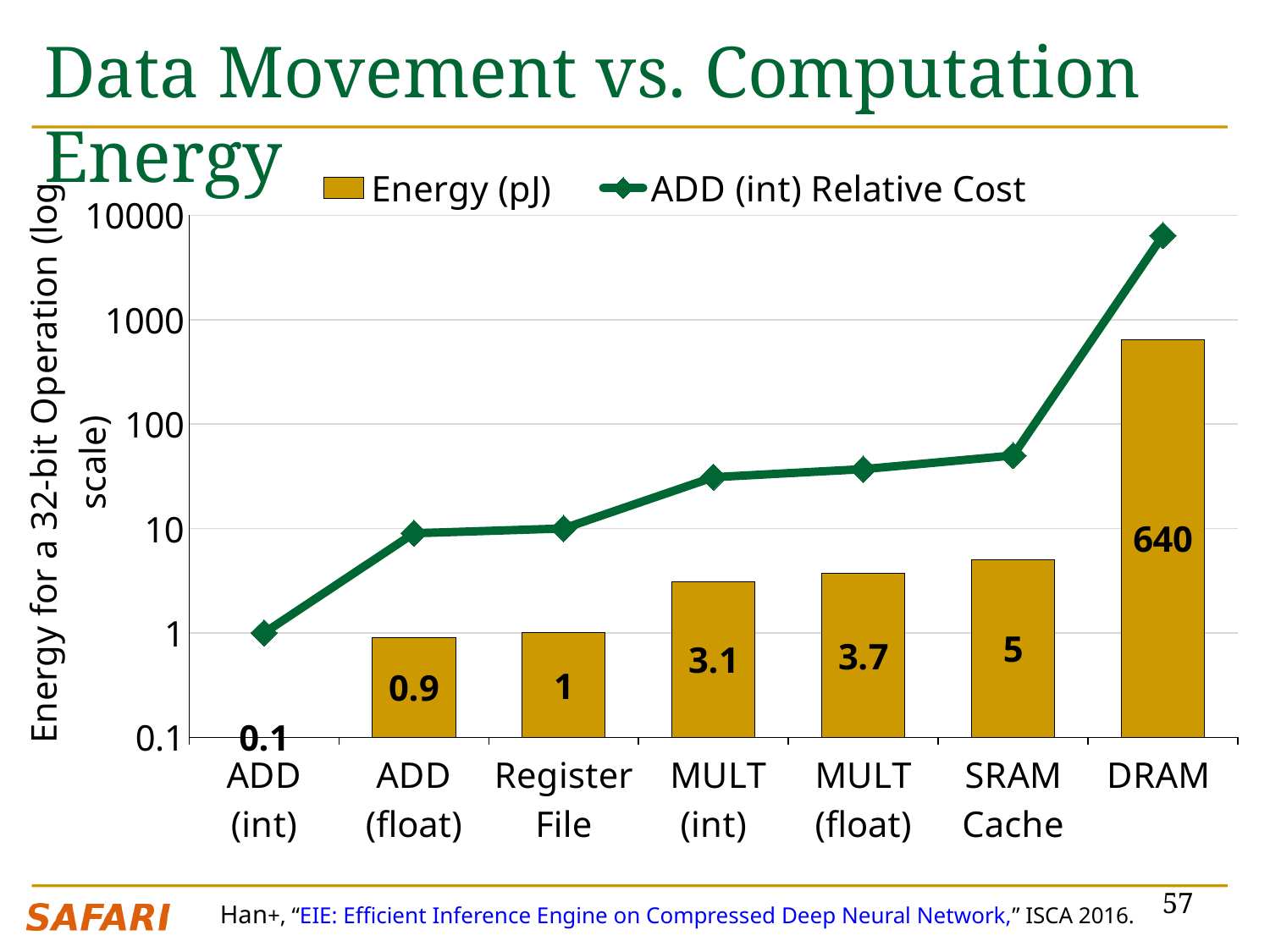
How many series does the legend list? 2 Which has a larger Energy (pJ) value, Register File or MULT (float)? MULT (float) What is the Energy (pJ) value for ADD (int)? 0.1 Is the ADD (int) Relative Cost value for DRAM greater or less than 1000? greater Which category has the highest Energy (pJ) value? DRAM Does the ADD (int) Relative Cost line rise or fall from ADD (int) to DRAM? rise What is the Energy (pJ) value for MULT (float)? 3.7 Is the ADD (int) Relative Cost value for SRAM Cache greater or less than 100? less Which category has the lowest Energy (pJ) value? ADD (int) What is the Energy (pJ) value for DRAM? 640 What is the difference in Energy (pJ) between SRAM Cache and MULT (int)? 1.9 How many categories are shown on the x axis? 7